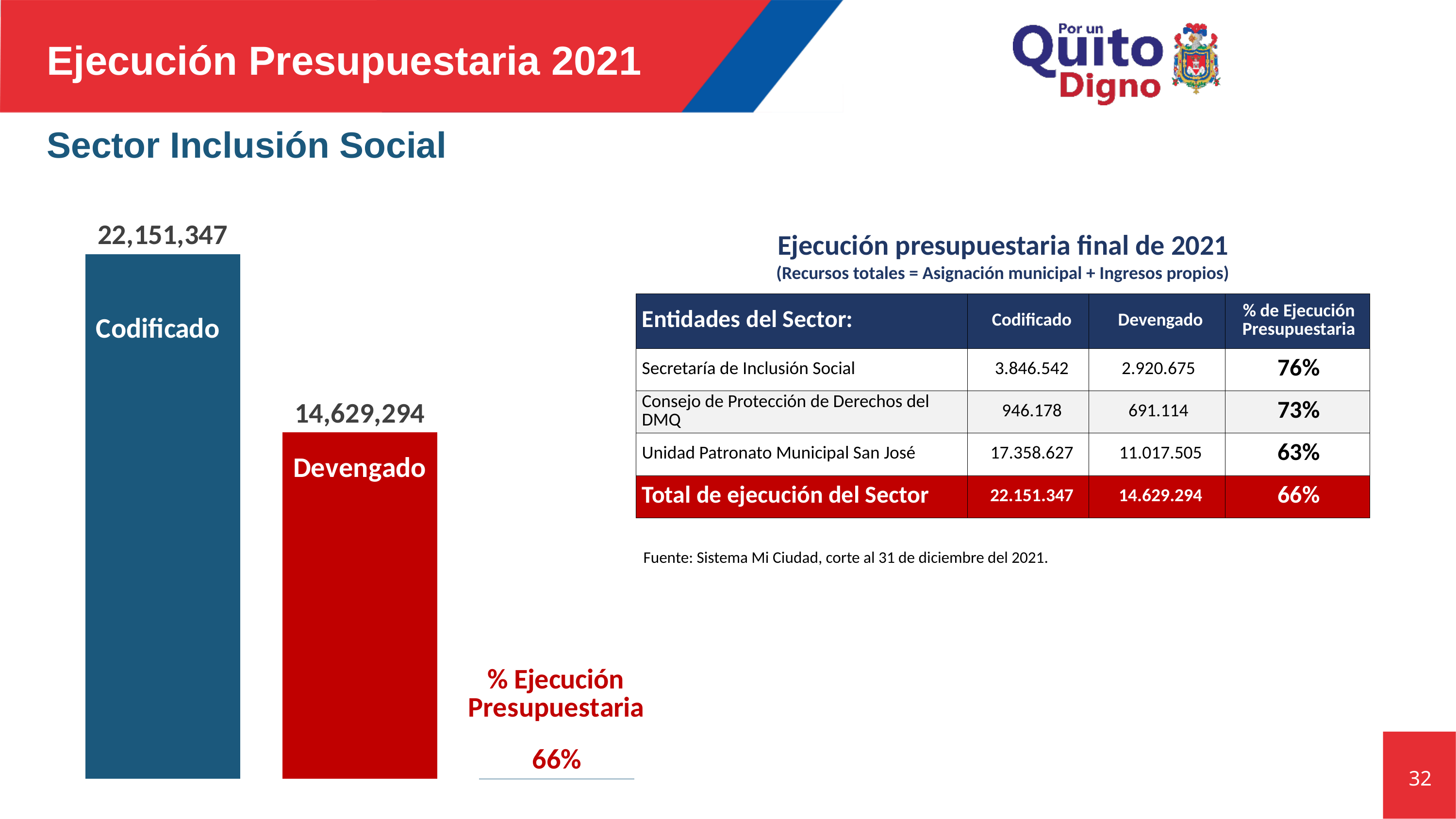
What colour is the Devengado bar in the chart? Red What is the difference between the Codificado and Devengado values in the bar chart? 7,522,053 How many bars are shown in the bar chart? 2 Which bar in the chart is the highest? Codificado What percentage of budget execution (% Ejecución Presupuestaria) is shown next to the bar chart? 66% What is the value of the Codificado bar in the bar chart? 22,151,347 What type of chart is shown on the left of the slide? Bar chart Which bar in the chart is the lowest? Devengado What is the value of the Devengado bar in the bar chart? 14,629,294 Which is larger in the bar chart, Codificado or Devengado? Codificado